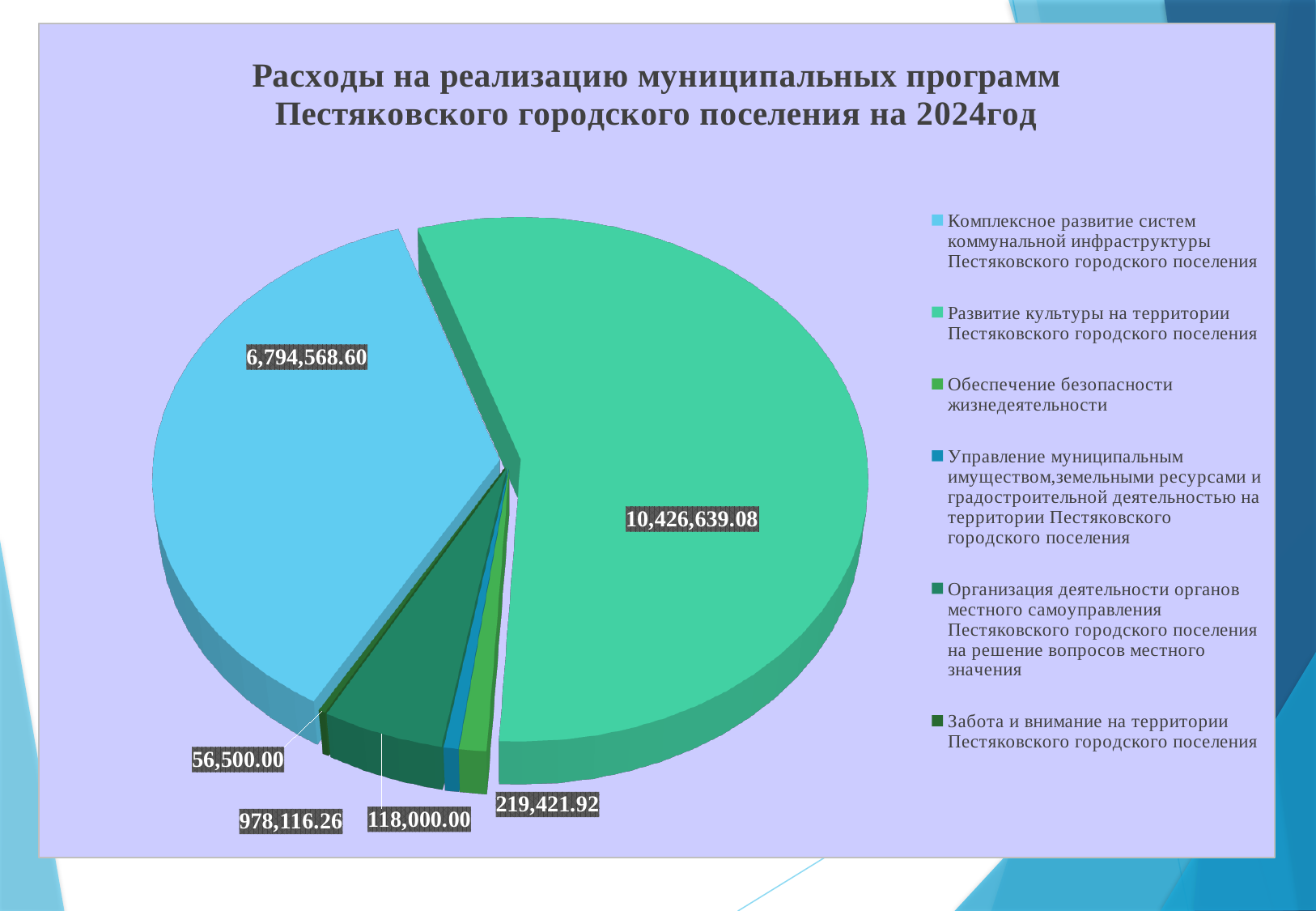
Which is larger: the value for «Организация деятельности органов местного самоуправления» or the value for «Обеспечение безопасности жизнедеятельности»? Организация деятельности органов местного самоуправления Which program has the largest expenditure? Развитие культуры на территории Пестяковского городского поселения What is the value for «Забота и внимание на территории Пестяковского городского поселения»? 56,500.00 What is the difference between the values for «Обеспечение безопасности жизнедеятельности» and «Управление муниципальным имуществом, земельными ресурсами и градостроительной деятельностью»? 101,421.92 What is the difference between the values for «Развитие культуры» and «Комплексное развитие систем коммунальной инфраструктуры»? 3,632,070.48 What is the value for «Обеспечение безопасности жизнедеятельности»? 219,421.92 Which program has the smallest expenditure? Забота и внимание на территории Пестяковского городского поселения What type of chart is shown on the slide? Pie chart How many slices does the pie chart have? 6 What is the title of the chart? Расходы на реализацию муниципальных программ Пестяковского городского поселения на 2024год What is the value for «Комплексное развитие систем коммунальной инфраструктуры Пестяковского городского поселения»? 6,794,568.60 What is the value for «Развитие культуры на территории Пестяковского городского поселения»? 10,426,639.08